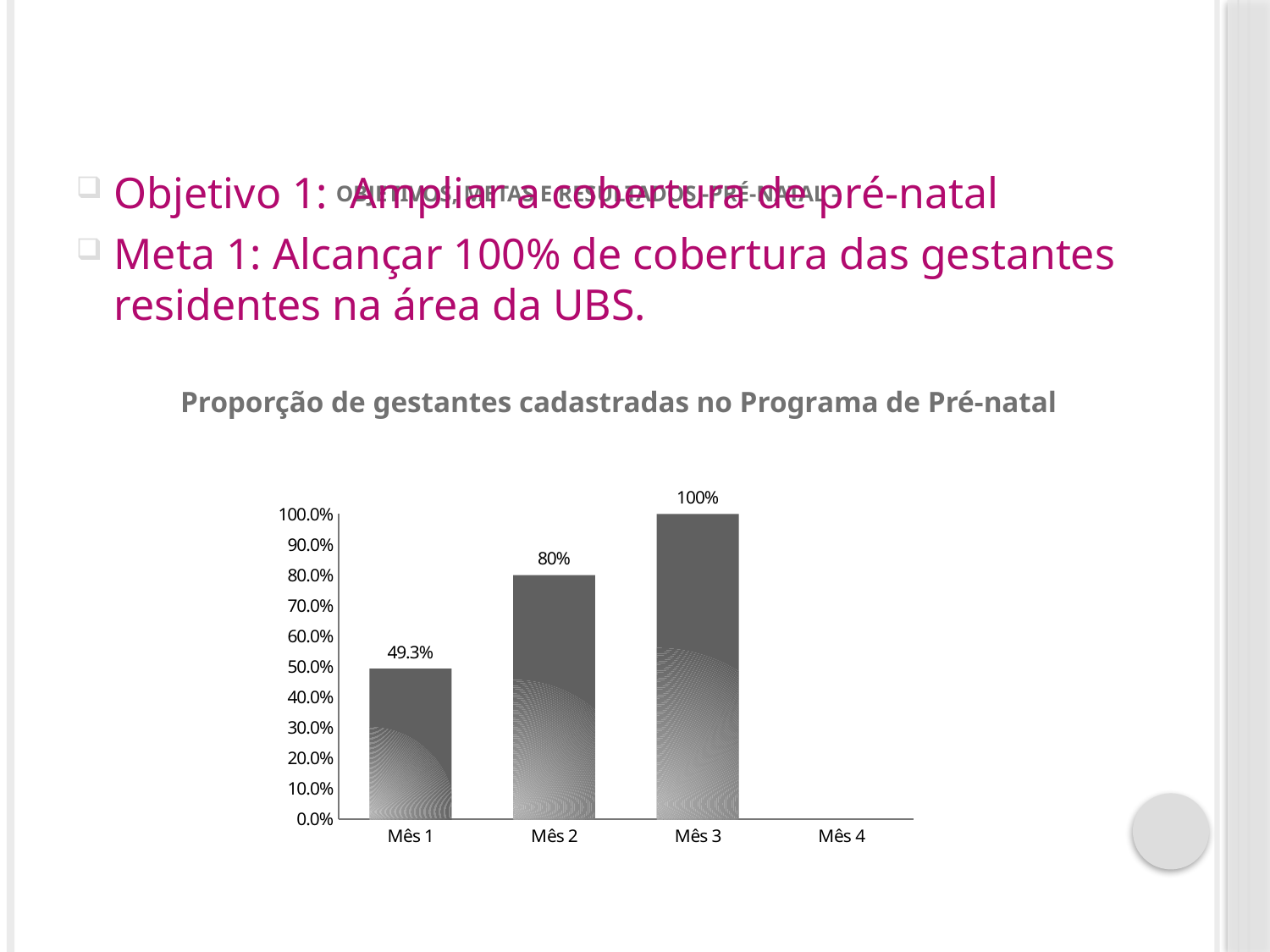
What is the difference between the values for Mês 2 and Mês 1? 30.7% What is the value for Mês 1 in the chart? 49.3% Among the months with a plotted bar, which has the lowest value? Mês 1 What is the difference between the values for Mês 3 and Mês 2? 20% What kind of chart is shown on the slide? bar chart Is the value for Mês 1 greater or less than 50.0%? less How many month categories are labelled on the x axis? 4 Which month has the highest value in the chart? Mês 3 Which is larger, the value for Mês 1 or the value for Mês 2? Mês 2 Do the values rise or fall from Mês 1 to Mês 3? rise What is the value for Mês 3 in the chart? 100% What is the value for Mês 2 in the chart? 80%